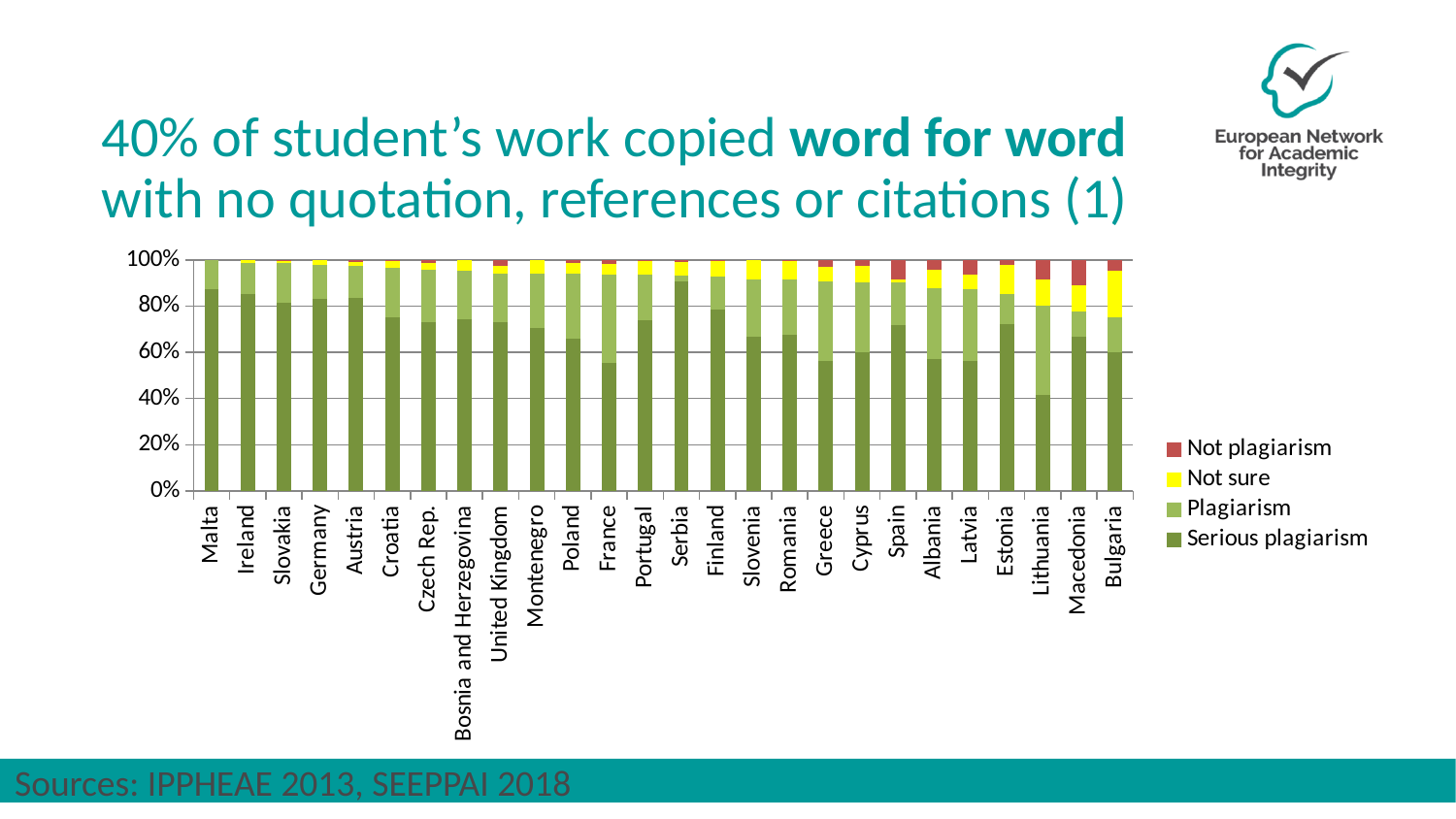
Is the Serious plagiarism value for Malta greater or less than 80%? greater Which country has the lowest share of Serious plagiarism? Lithuania What is the total height of each stacked bar in the chart? 100% Which country has the highest share of Serious plagiarism? Serbia What kind of chart is shown on the slide? Stacked bar chart How many countries are shown on the x axis of the chart? 26 What sources are cited at the bottom of the slide? IPPHEAE 2013, SEEPPAI 2018 How many series does the chart legend list? 4 Is the Serious plagiarism value for Lithuania greater or less than 60%? less Which has a larger Serious plagiarism share, Malta or Lithuania? Malta Is the Serious plagiarism value for France greater or less than 60%? less Which series is shown in yellow in the chart legend? Not sure